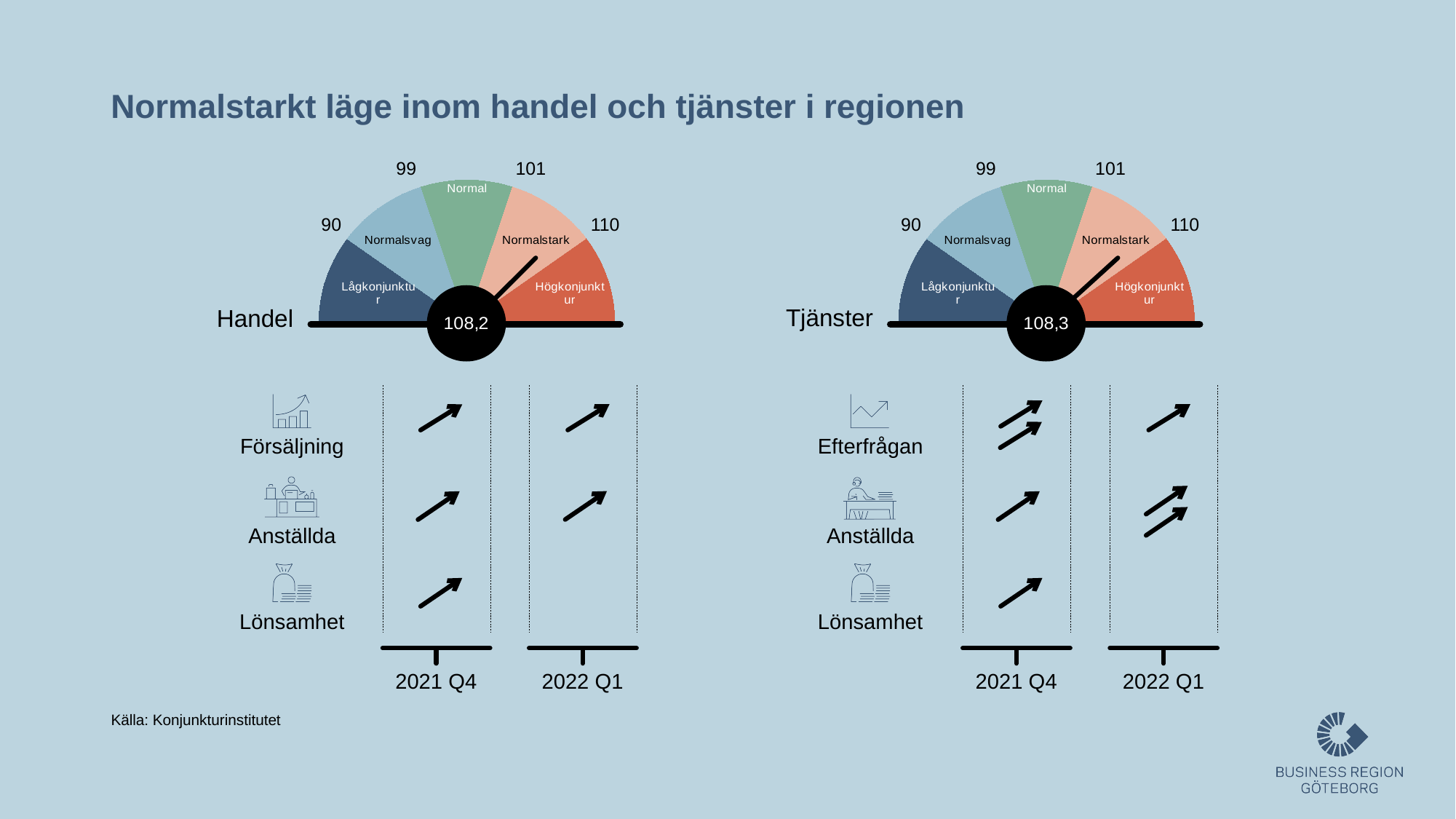
On the Tjänster gauge chart, what is the label of the green segment? Normal How many coloured segments does the Handel gauge chart have? 5 On the Handel gauge chart, what value is shown in the centre of the gauge? 108,2 On the Tjänster gauge chart, is the value greater or less than 110? less On the Handel gauge chart, what tick value is shown at the boundary between Normalstark and Högkonjunktur? 110 What is the difference between the Tjänster gauge value and the Handel gauge value? 0,1 What kind of chart is used to show the Handel and Tjänster values? Gauge chart In the Tjänster indicator table, how many arrows are shown for Anställda in 2022 Q1? 2 Which gauge shows the higher value, Handel or Tjänster? Tjänster On the Handel gauge chart, is the value greater or less than 101? greater On the Handel gauge chart, which segment does the needle point into? Normalstark On the Tjänster gauge chart, what value is shown in the centre of the gauge? 108,3